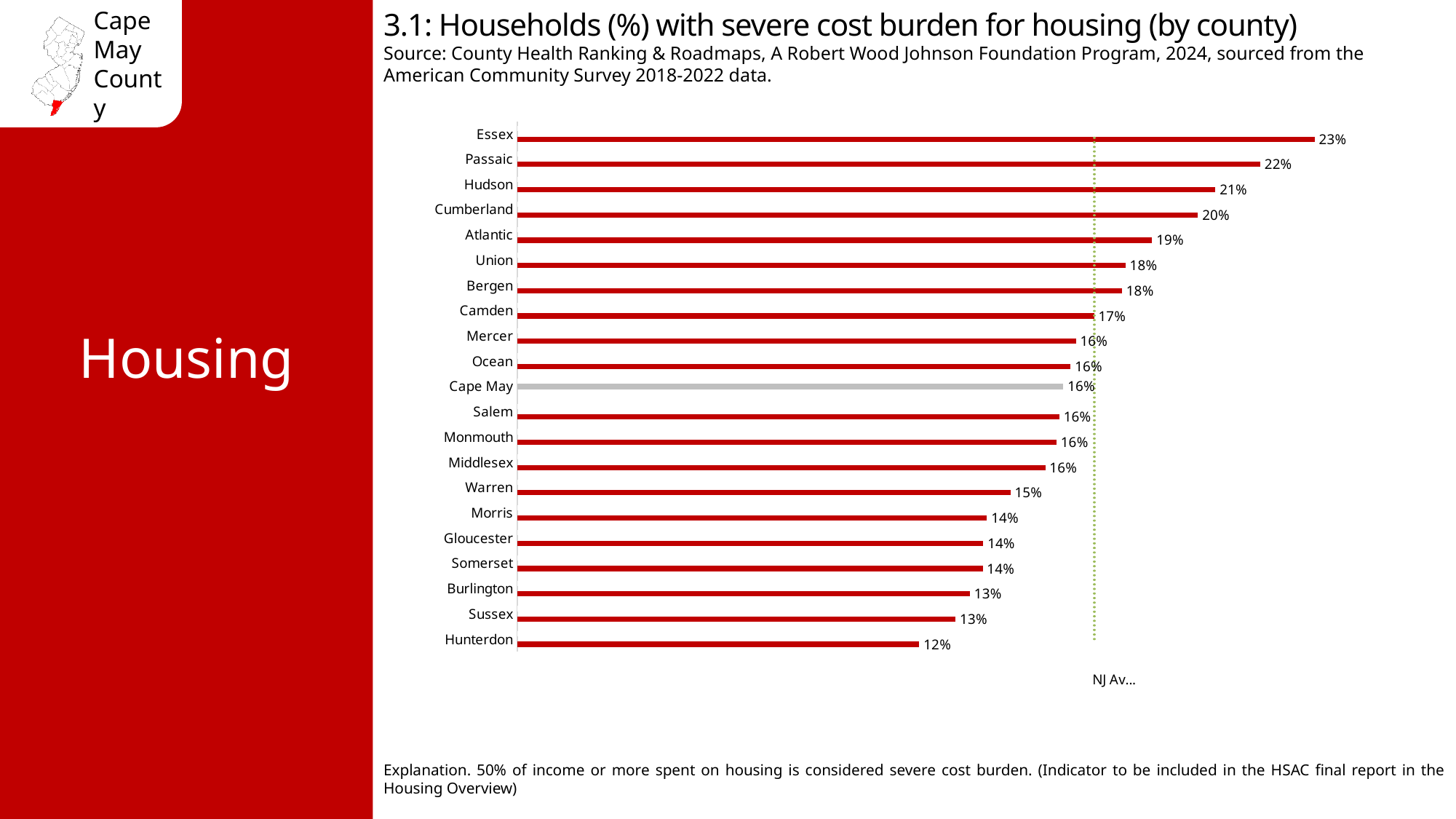
What is the value shown for Essex County? 23% How many counties are shown in the chart? 21 Which county's bar is shown in gray rather than red? Cape May Which has a higher value, Passaic or Burlington? Passaic Which has a higher value, Atlantic or Warren? Atlantic Which county has the lowest percentage of households with severe housing cost burden? Hunterdon What is the value shown for Hunterdon County? 12% What percentage of households in Cape May County have a severe cost burden for housing? 16% Which county has the highest percentage of households with severe housing cost burden? Essex What is the difference between the values for Essex and Hunterdon? 11 percentage points What kind of chart is shown on the slide? Bar chart What is the difference between the values for Cumberland and Cape May? 4 percentage points